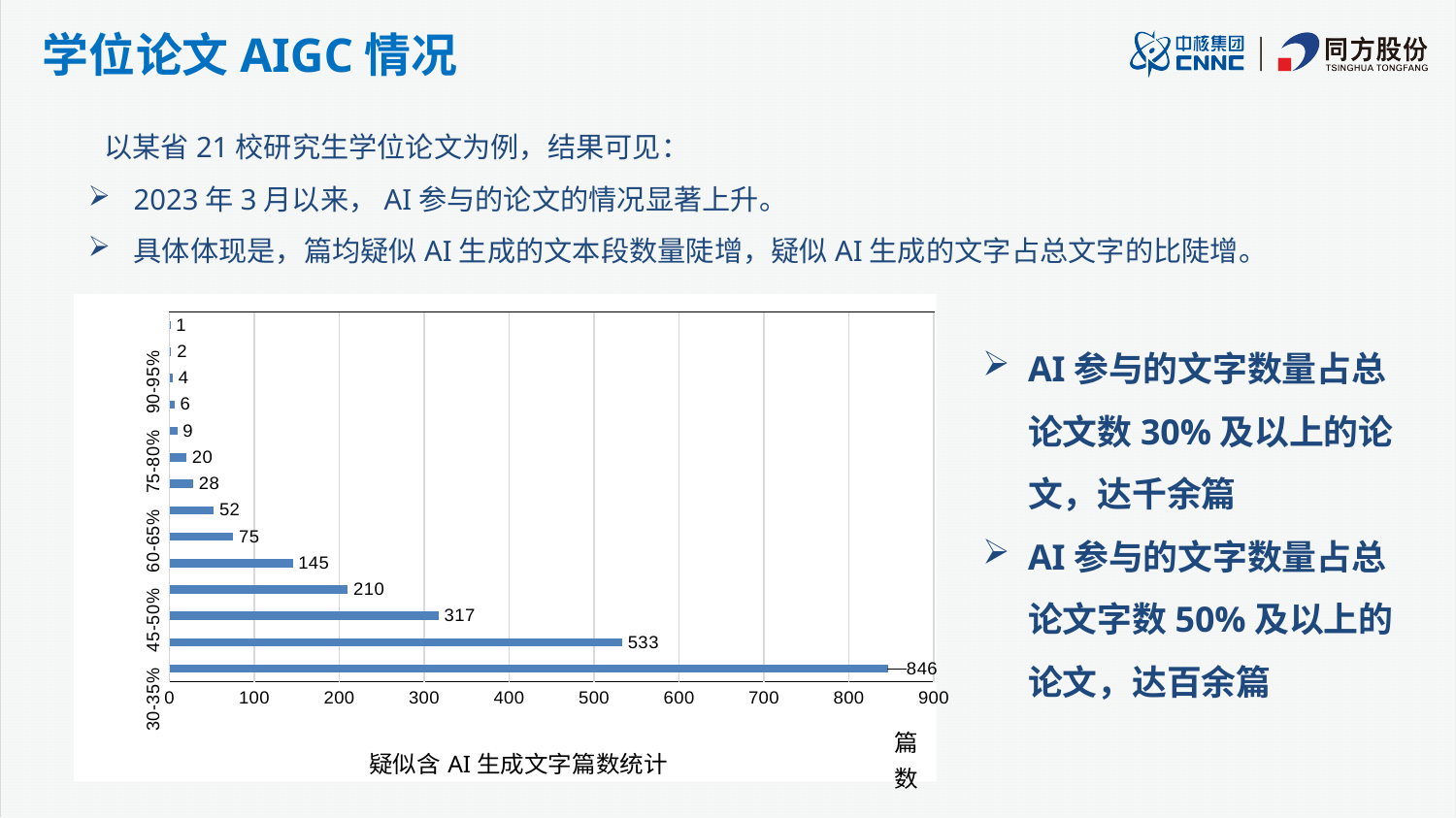
What is the difference between the bars labelled 317 and 210? 107 What is the difference between the two longest bars in the chart (846 and 533)? 313 What is the largest value shown in the chart? 846 What is the smallest value shown in the chart? 1 What is the title of the chart? 疑似含 AI 生成文字篇数统计 Is the longest bar in the chart greater or less than 800? greater What is the highest tick value shown on the horizontal axis of the chart? 900 Do the bar values increase or decrease going from the top of the chart to the bottom? increase What type of chart is shown on the slide? bar chart Which is larger, the bar labelled 145 or the bar labelled 75? 145 How many bars are plotted in the chart? 14 How many bars in the chart have a value above 500? 2